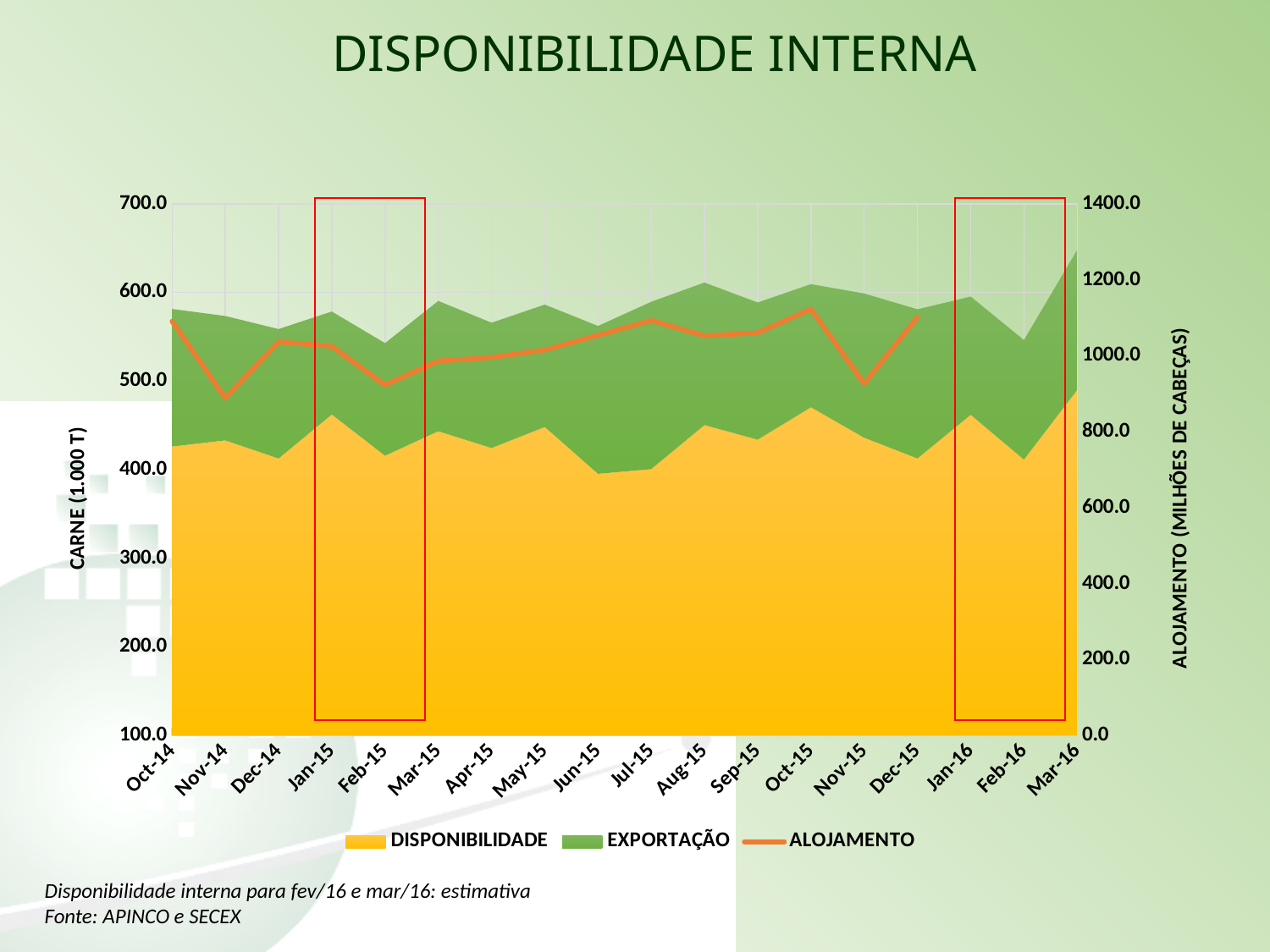
What kind of chart is this? Area chart with a line series In which month does the ALOJAMENTO line reach its lowest point? Nov-14 How many months are shown on the x axis? 18 How many series does the legend list? 3 Which is larger, the DISPONIBILIDADE value for Jan-15 or for Jun-15? Jan-15 What is the label of the right-hand (secondary) vertical axis? ALOJAMENTO (MILHÕES DE CABEÇAS) Does the DISPONIBILIDADE area rise or fall from Jan-15 to Jun-15? fall Is the ALOJAMENTO value for Nov-14 greater or less than 1000.0 on the right axis? less What is the title of the chart? DISPONIBILIDADE INTERNA Is the DISPONIBILIDADE value for Jan-15 greater or less than 400? greater